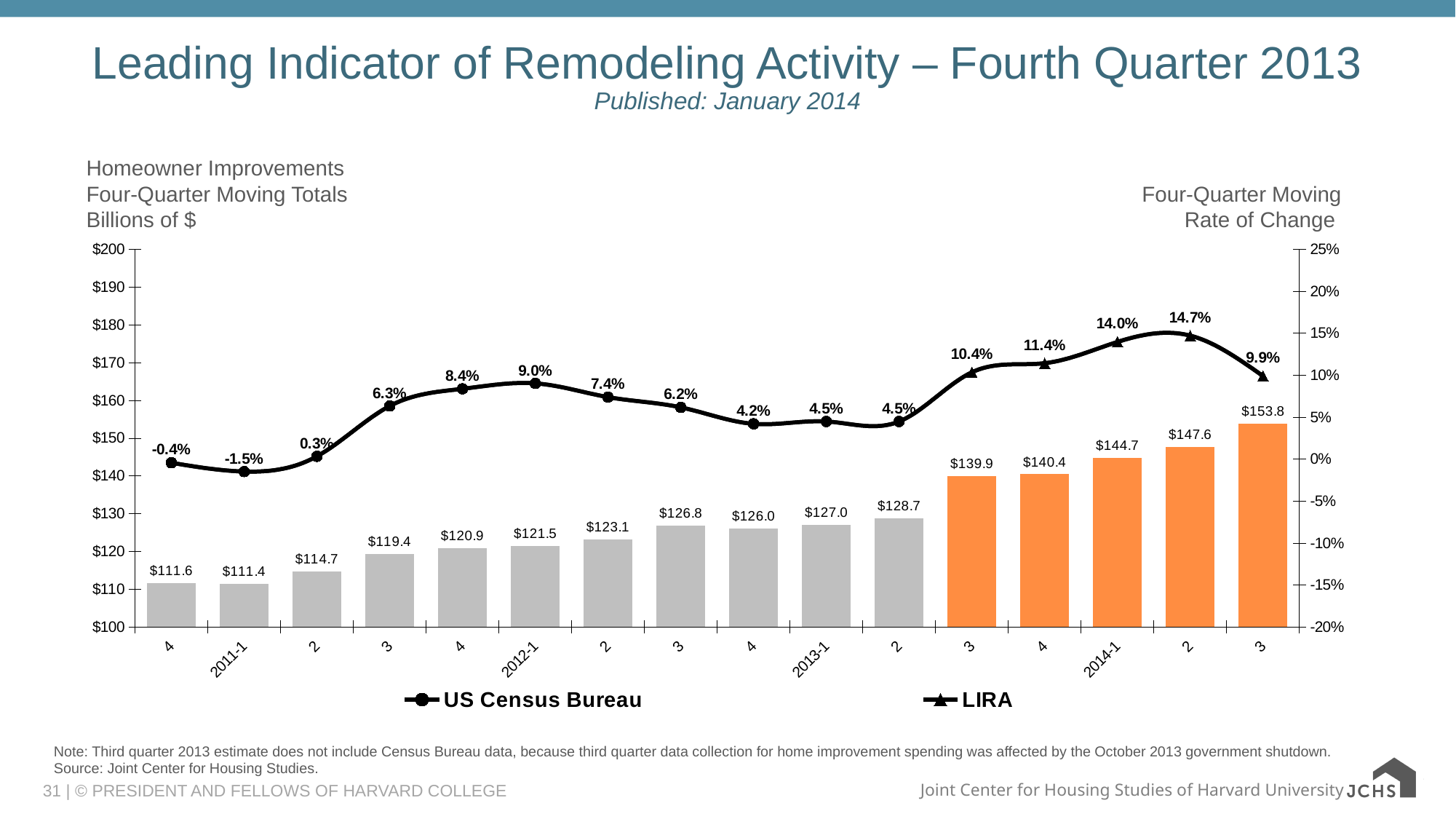
What is the four-quarter moving total for 2013-2? $128.7 What is the highest four-quarter moving rate of change shown on the line? 14.7% Which quarter has the highest four-quarter moving total? 2014-3 ($153.8) What kind of chart is used to show the four-quarter moving totals in billions of dollars? Bar chart What are the two series named in the legend? US Census Bureau and LIRA How many series does the legend list? 2 Which is larger, the four-quarter moving total for 2012-3 or for 2012-4? 2012-3 ($126.8) What is the four-quarter moving rate of change labeled at 2012-1? 9.0% What is the difference between the four-quarter moving totals for 2014-3 and 2014-2? $6.2 How many bars are plotted in the chart? 16 What is the four-quarter moving total for 2014-1? $144.7 Which quarter has the lowest four-quarter moving rate of change? 2011-1 (-1.5%)